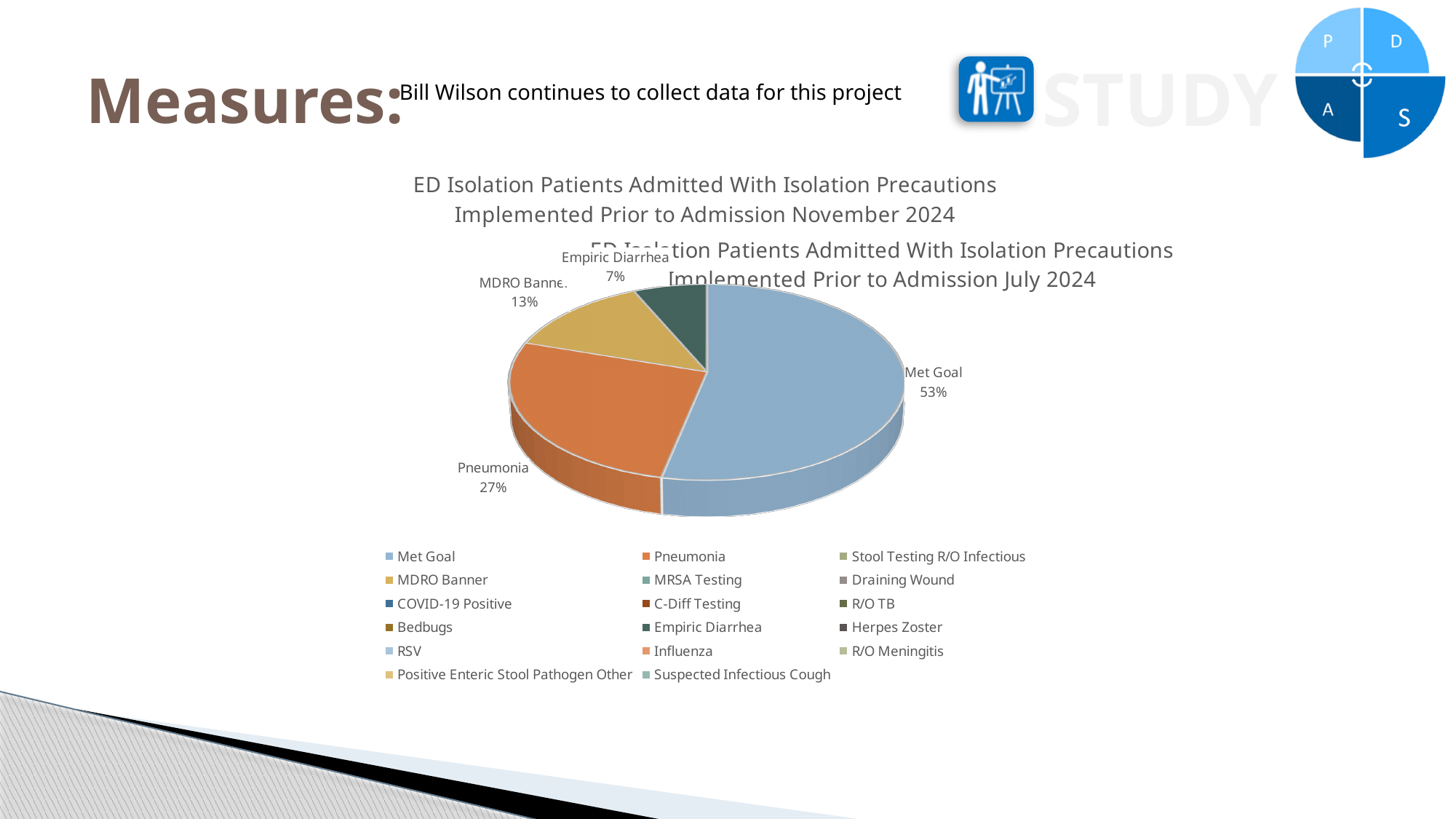
Which is larger, the MDRO Banner slice or the Empiric Diarrhea slice? MDRO Banner What share of the pie does Pneumonia represent? 27% How many entries does the legend of the pie chart list? 17 What type of chart is shown on the slide? pie chart What share of the pie does Met Goal represent? 53% What share of the pie does MDRO Banner represent? 13% What colour is the Met Goal slice in the pie chart? light blue How many slices with data labels are visible in the pie chart? 4 What is the difference in percentage points between the Met Goal slice and the Pneumonia slice? 26 Which slice of the pie is the largest? Met Goal What share of the pie does Empiric Diarrhea represent? 7% Which labelled slice of the pie is the smallest? Empiric Diarrhea